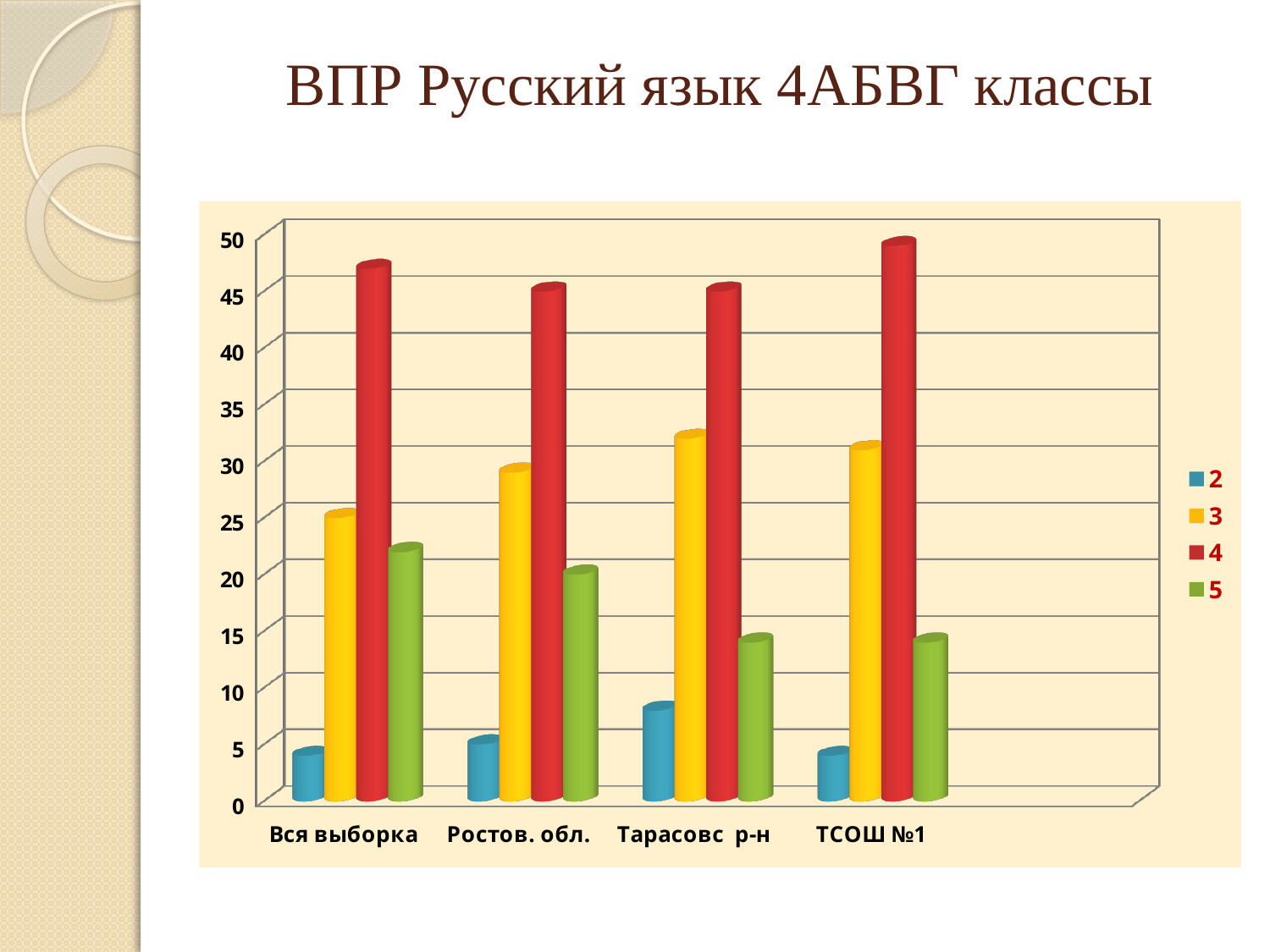
Is the value for series 3 in Тарасовс р-н greater or less than 30? greater Which category has the highest value for series 2? Тарасовс р-н How many categories are shown on the x axis of the chart? 4 Is the value for series 4 in Вся выборка greater or less than 45? greater What is the title of the slide containing the chart? ВПР Русский язык 4АБВГ классы Which category has the lowest value for series 3? Вся выборка How many series does the chart legend list? 4 Which is larger: the series 5 value for Вся выборка or for Тарасовс р-н? Вся выборка For the category ТСОШ №1, which series has the highest bar? 4 What kind of chart is shown on the slide? bar chart Which colour represents series 4 in the chart legend? red